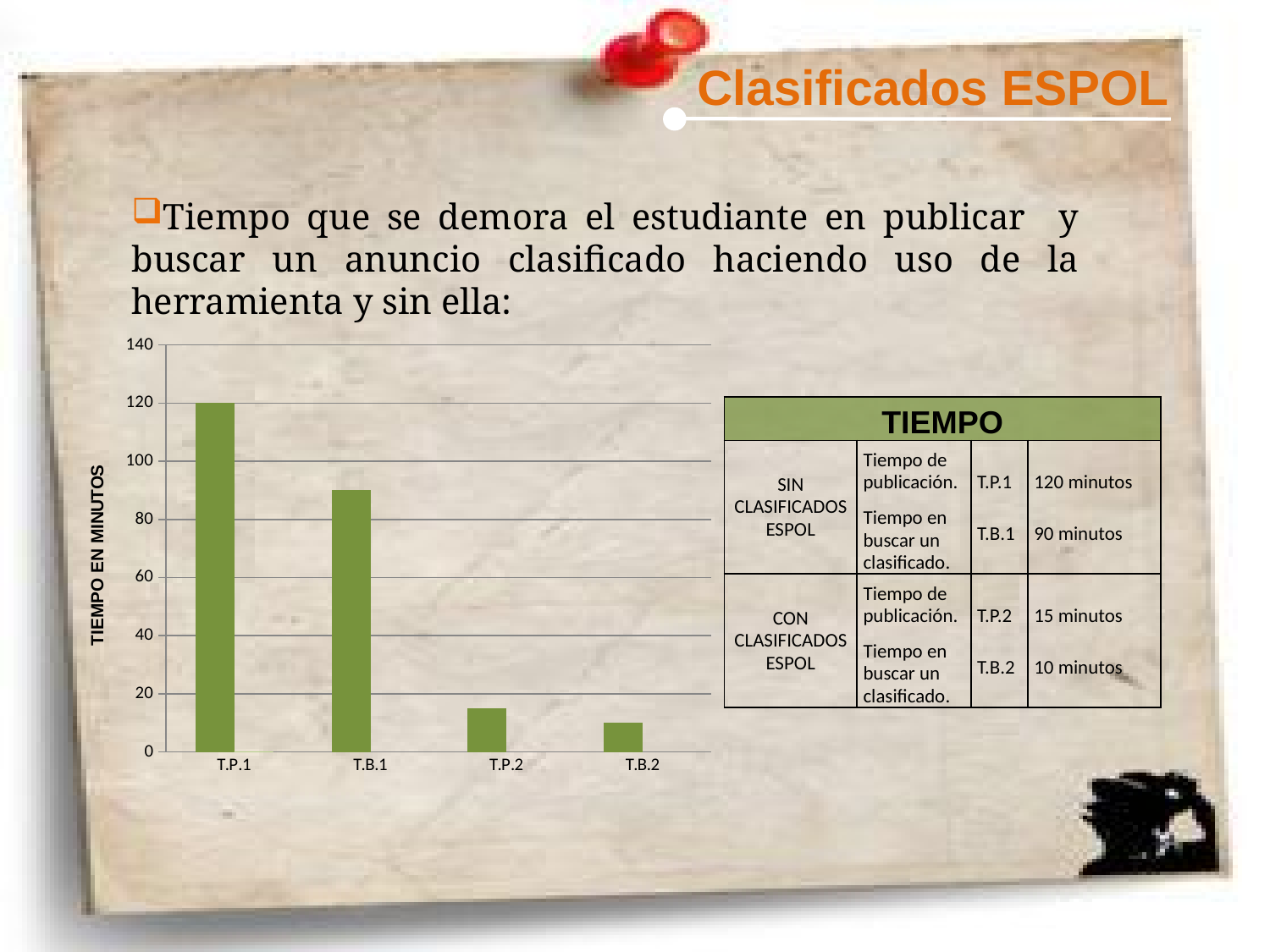
Is the value for T.B.1 greater or less than 80? greater Which category has the lowest bar in the chart? T.B.2 What is the value for T.P.1 according to the slide? 120 minutos What is the value for T.B.2 according to the slide? 10 minutos What kind of chart is shown on the slide? bar chart What is the difference between the values for T.P.1 and T.P.2? 105 minutos Which is larger, the value for T.B.1 or the value for T.P.2? T.B.1 Is the value for T.P.2 greater or less than 20? less What is the value for T.P.2 according to the slide? 15 minutos What is the value for T.B.1 according to the slide? 90 minutos How many bars (categories) does the chart show? 4 Which category has the highest bar in the chart? T.P.1